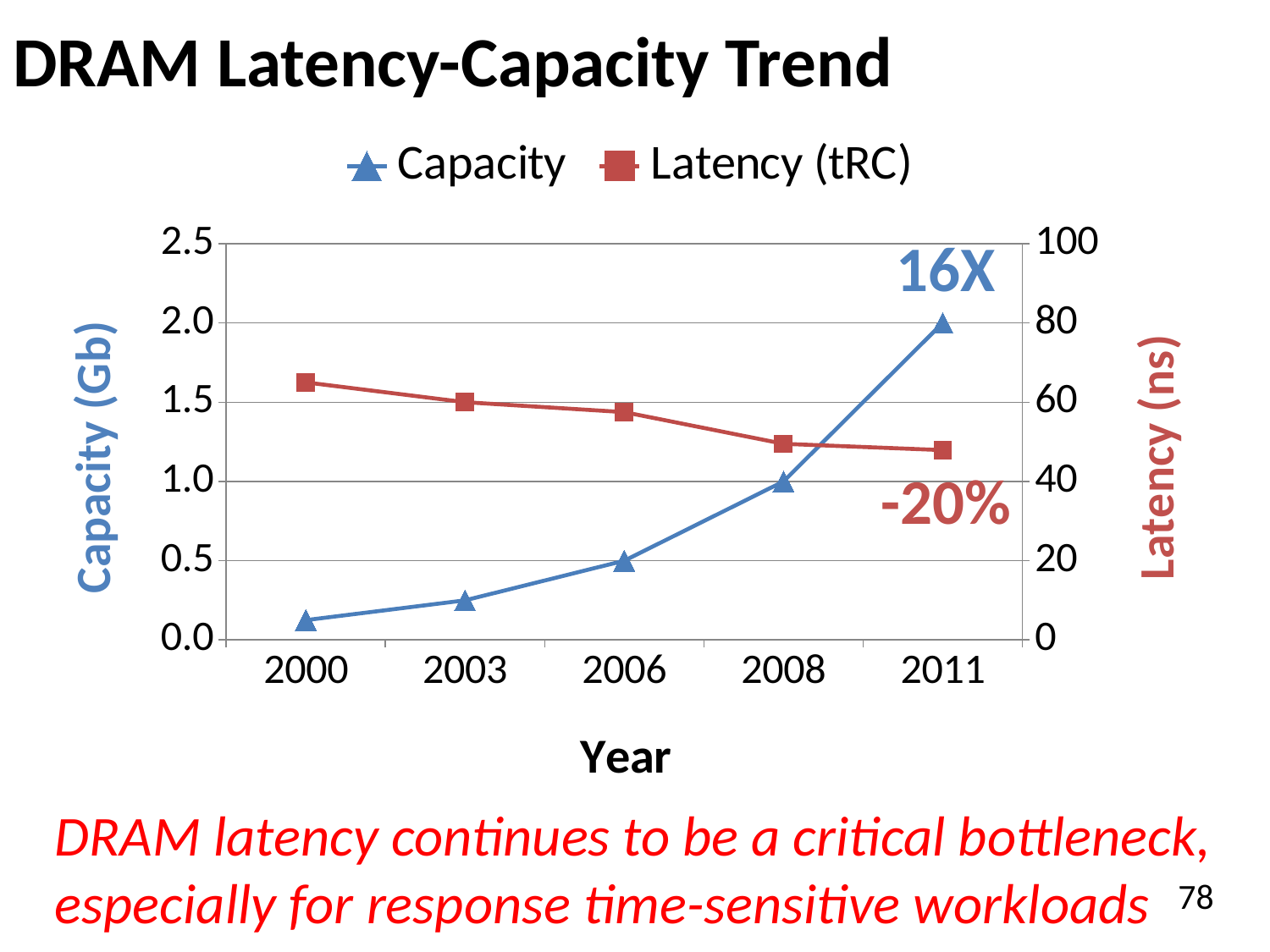
Is the Latency (tRC) value for 2000 greater or less than 60? greater How many years are plotted along the x axis? 5 Does the Capacity series rise or fall from 2000 to 2011? rise What is the Capacity value for 2011? 2.0 Which year has the highest Latency (tRC) value? 2000 Is the Latency (tRC) value for 2011 greater or less than 60? less What is the label of the left vertical axis? Capacity (Gb) How many series does the legend list? 2 What kind of chart is shown on the slide? line chart What is the Capacity value for 2008? 1.0 Is the Capacity value for 2006 greater or less than 1.0? less Does the Latency (tRC) series rise or fall from 2000 to 2011? fall